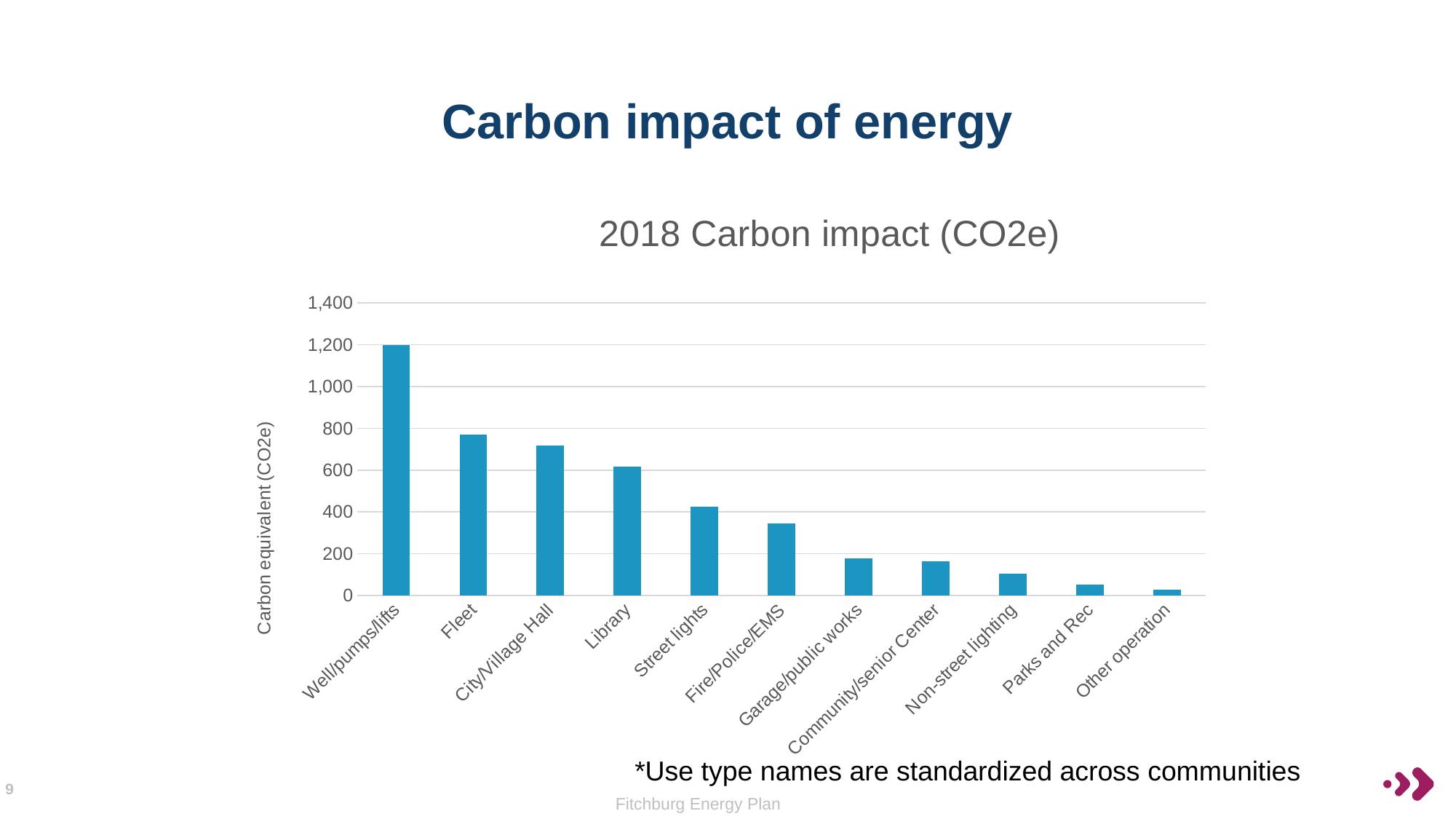
Which category has the lowest 2018 carbon impact? Other operation Is the value for Well/pumps/lifts greater or less than 1,000? greater How many categories are plotted on the chart? 11 Is the value for Fleet greater or less than 800? less Do the values rise or fall moving from left to right along the x axis? fall What kind of chart is shown on the slide? bar chart What is the title of the chart? 2018 Carbon impact (CO2e) Is the value for Street lights greater or less than 400? greater Which category has the highest 2018 carbon impact? Well/pumps/lifts Which is larger, the value for Library or the value for Street lights? Library